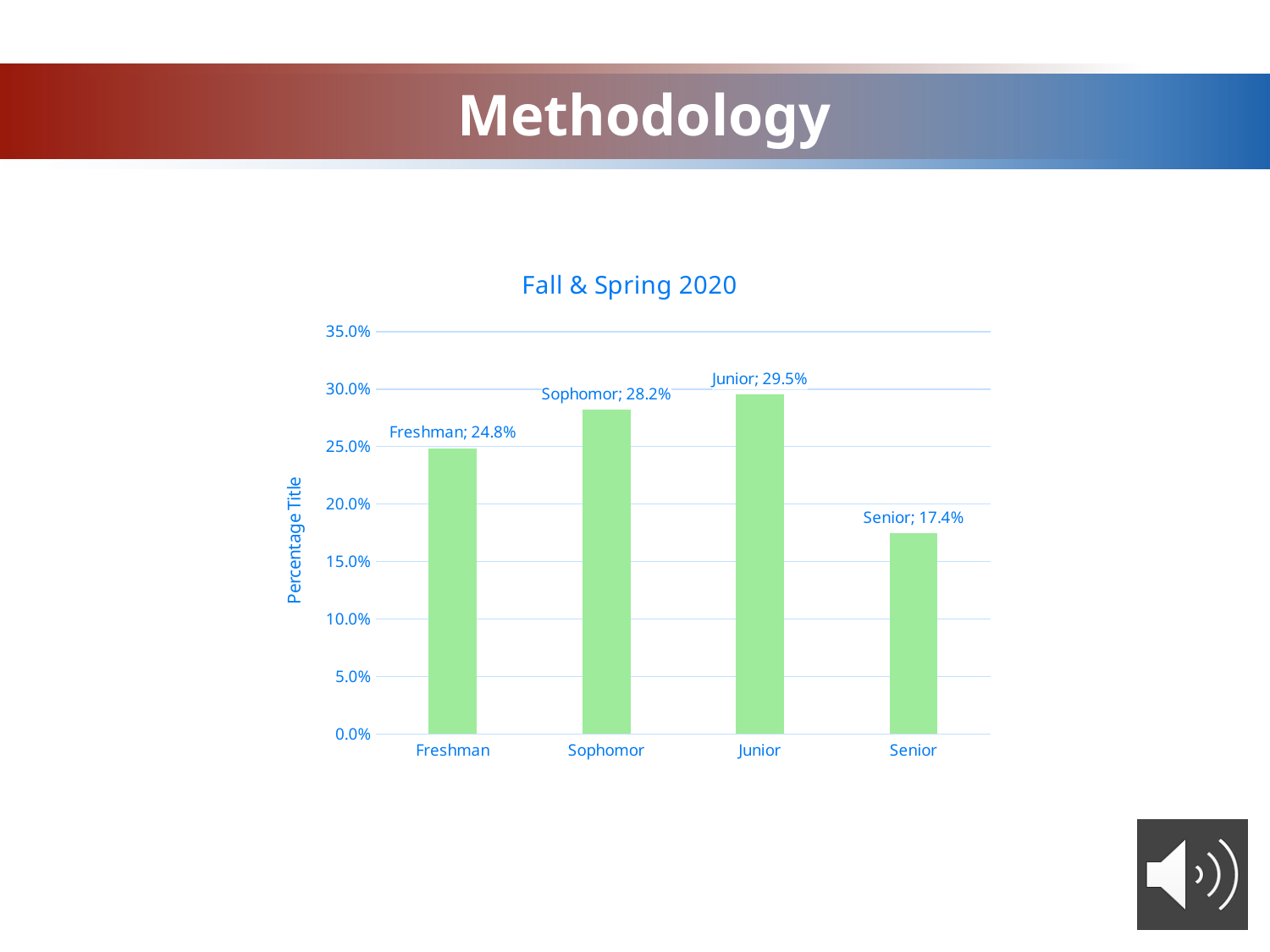
Which category has the highest value? Junior Which is larger, the value for Sophomor or the value for Freshman? Sophomor What is the difference between the Junior and Senior values? 12.1% What is the value for Senior? 17.4% What is the title of the chart? Fall & Spring 2020 What kind of chart is shown? bar chart Is the value for Senior greater or less than 20.0%? less Which category has the lowest value? Senior What is the value for Junior? 29.5% What is the difference between the Sophomor and Freshman values? 3.4% How many categories are shown on the x axis? 4 What is the value for Freshman? 24.8%